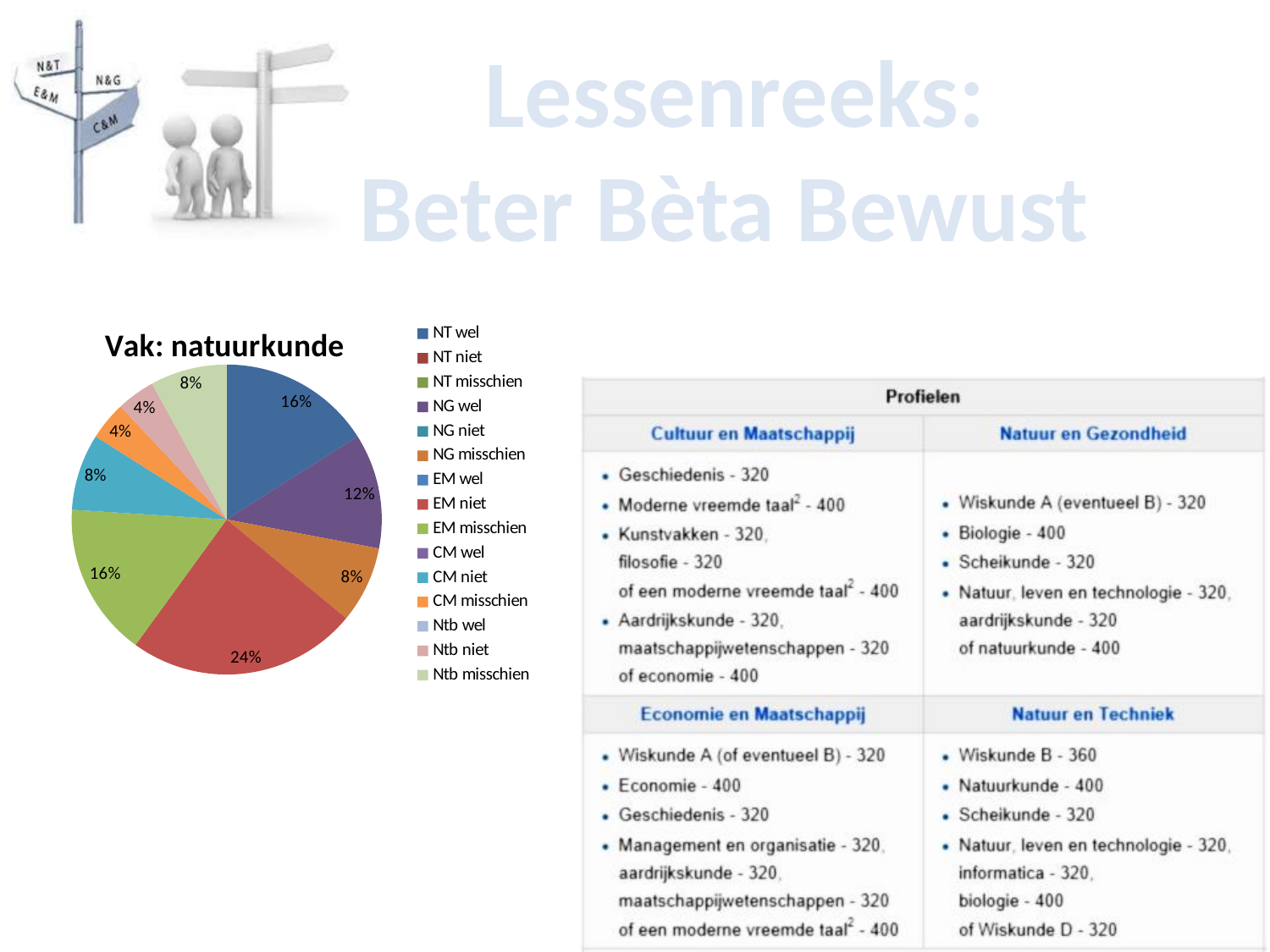
What kind of chart is shown on the slide? pie chart How many entries does the legend of the pie chart list? 15 What is the percentage of the smallest slices in the pie chart? 4% What is the title of the pie chart? Vak: natuurkunde Which is larger in the pie chart: the red slice or the purple slice? the red slice What share of the pie does the dark blue slice for NT wel represent? 16% How many slices does the pie chart have? 9 What is the difference between the largest slice (24%) and a smallest slice (4%) in the pie chart? 20% How many slices in the pie chart are labelled 16%? 2 How many slices in the pie chart are labelled 8%? 3 Which legend entry is listed first in the pie chart's legend? NT wel What is the percentage of the largest slice in the pie chart? 24%